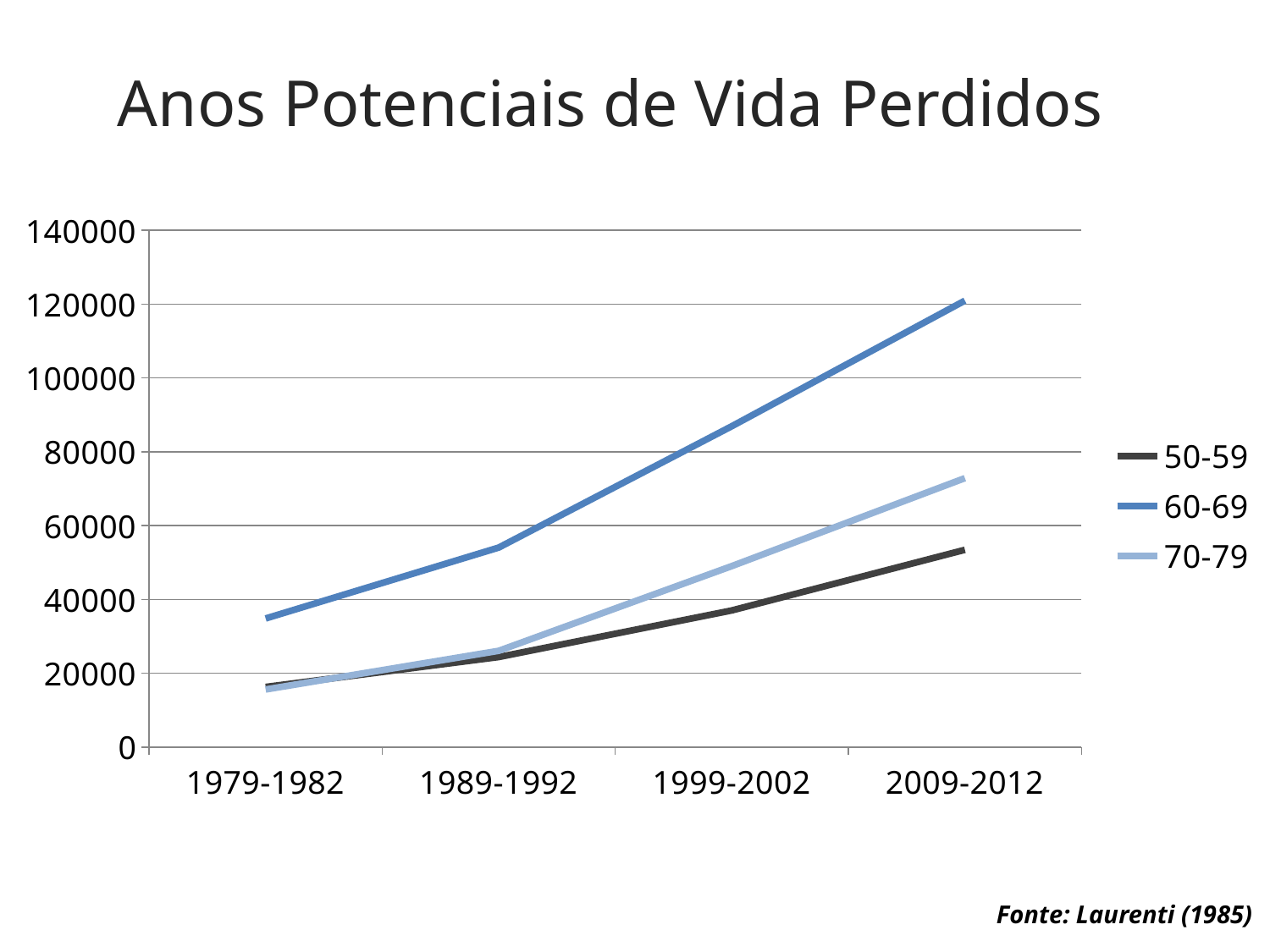
What is the title of the chart? Anos Potenciais de Vida Perdidos What kind of chart is shown on the slide? line chart How many periods are shown on the x axis? 4 Which series has the highest value in 2009-2012? 60-69 How many series does the legend list? 3 Is the value for 60-69 in 1979-1982 greater or less than 40000? less Is the value for 70-79 in 2009-2012 greater or less than 60000? greater Do the values for the 60-69 series rise or fall from 1979-1982 to 2009-2012? rise Which series has the lowest value in 2009-2012? 50-59 Is the value for 50-59 in 1979-1982 greater or less than 20000? less In 2009-2012, which is larger: the value for 70-79 or the value for 50-59? 70-79